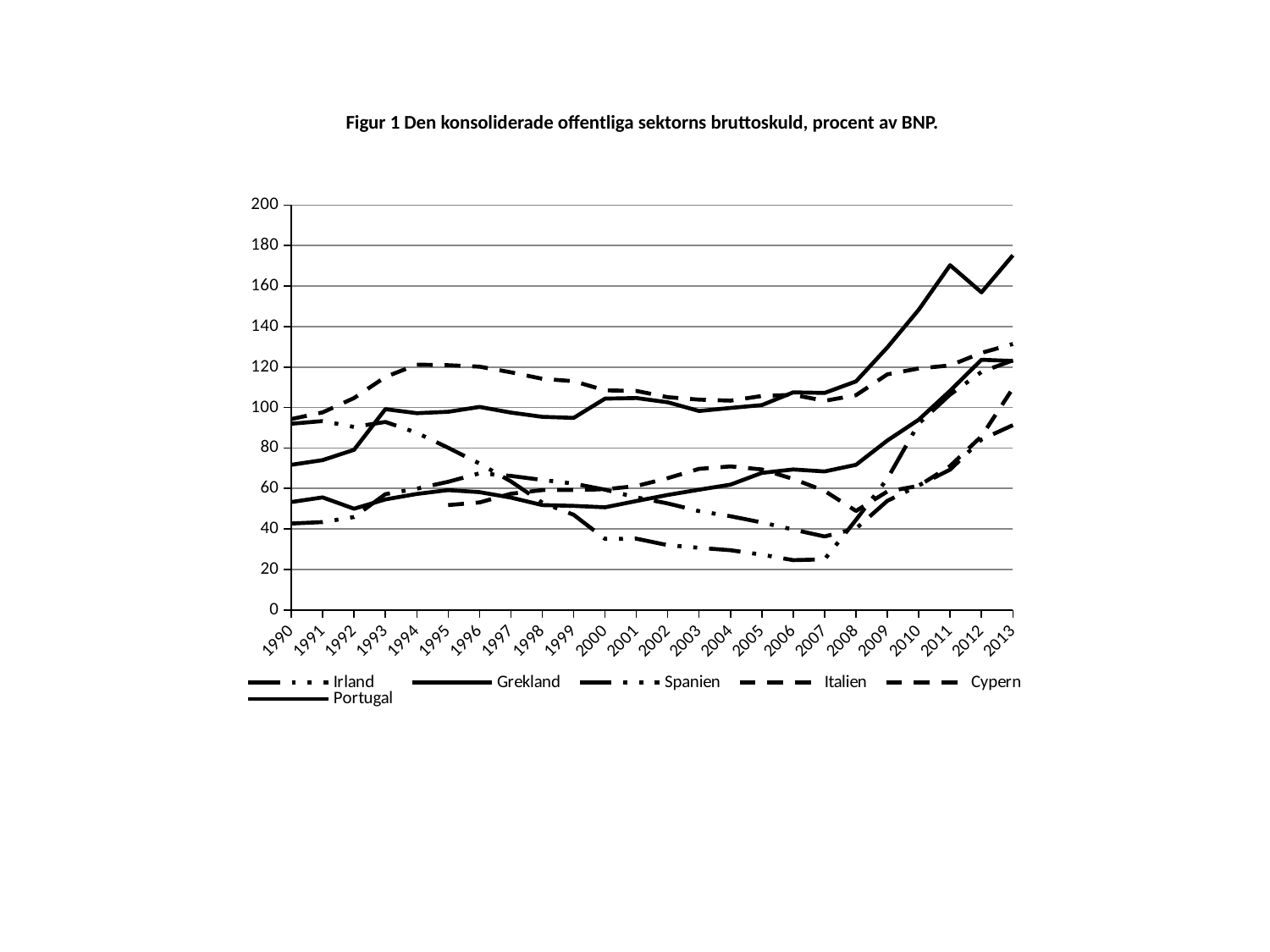
How many series does the legend list? 6 Is the value for Grekland in 2013 greater or less than 140? greater Is the value for Portugal in 1990 greater or less than 60? less Which country has the highest value in 2013? Grekland What kind of chart is shown on the slide? line chart Is the value for Grekland in 2011 greater or less than 160? greater Which is larger in 2013, the value for Grekland or the value for Italien? Grekland Does the value for Grekland rise or fall between 2008 and 2011? rise How many years are shown on the x axis? 24 What is the first year shown on the x axis? 1990 What is the title of the chart? Figur 1 Den konsoliderade offentliga sektorns bruttoskuld, procent av BNP.